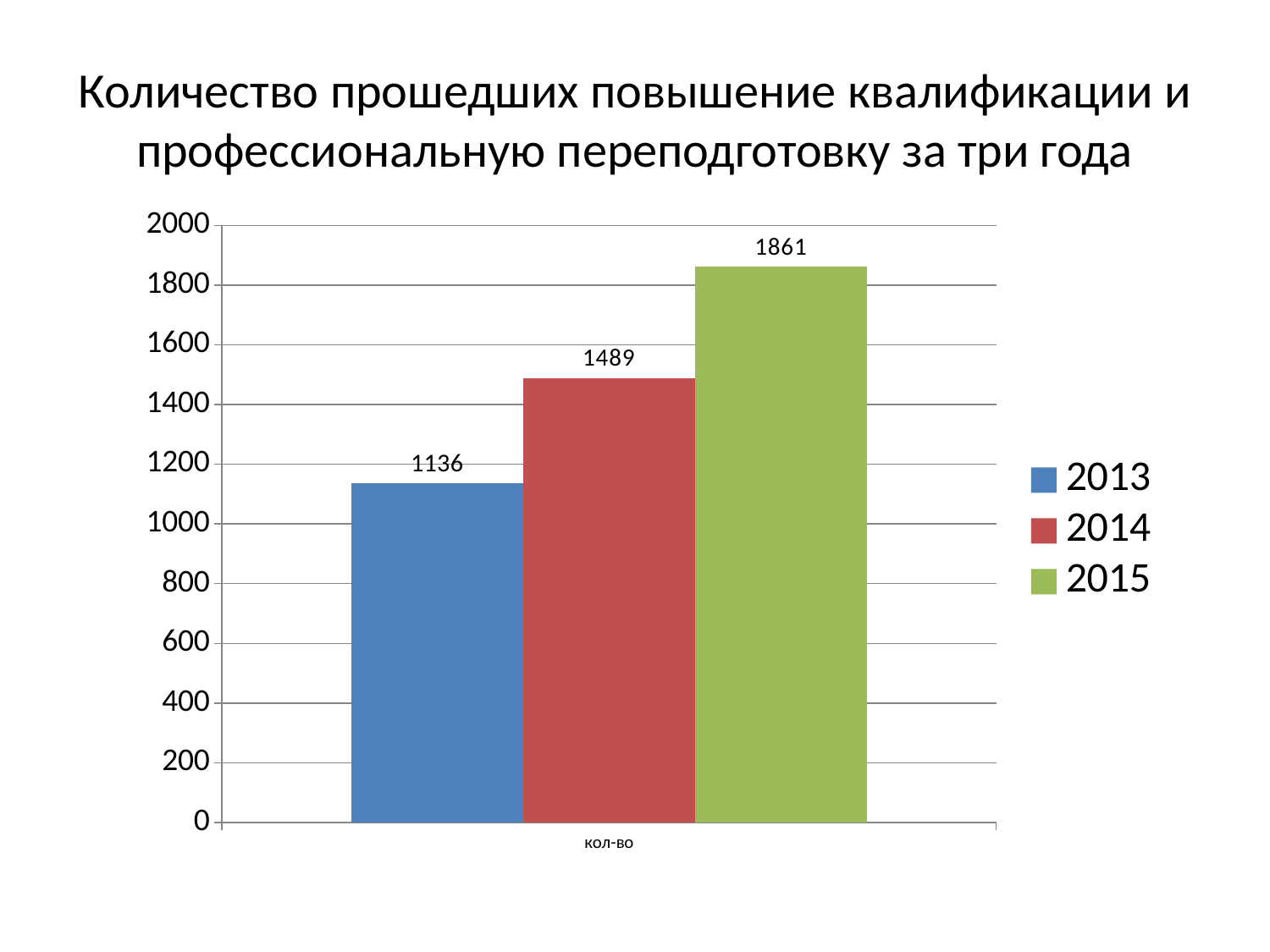
Is the value for 2014 greater or less than 1400? greater Which is larger, the value for 2014 or the value for 2015? 2015 What kind of chart is shown on the slide? bar chart What is the difference between the values for 2014 and 2013? 353 Which year has the highest value? 2015 What is the difference between the values for 2015 and 2013? 725 What is the value for 2015? 1861 How many series does the legend list? 3 What is the value for 2014? 1489 What is the value for 2013? 1136 Do the values rise or fall from 2013 to 2015? rise Which year has the lowest value? 2013